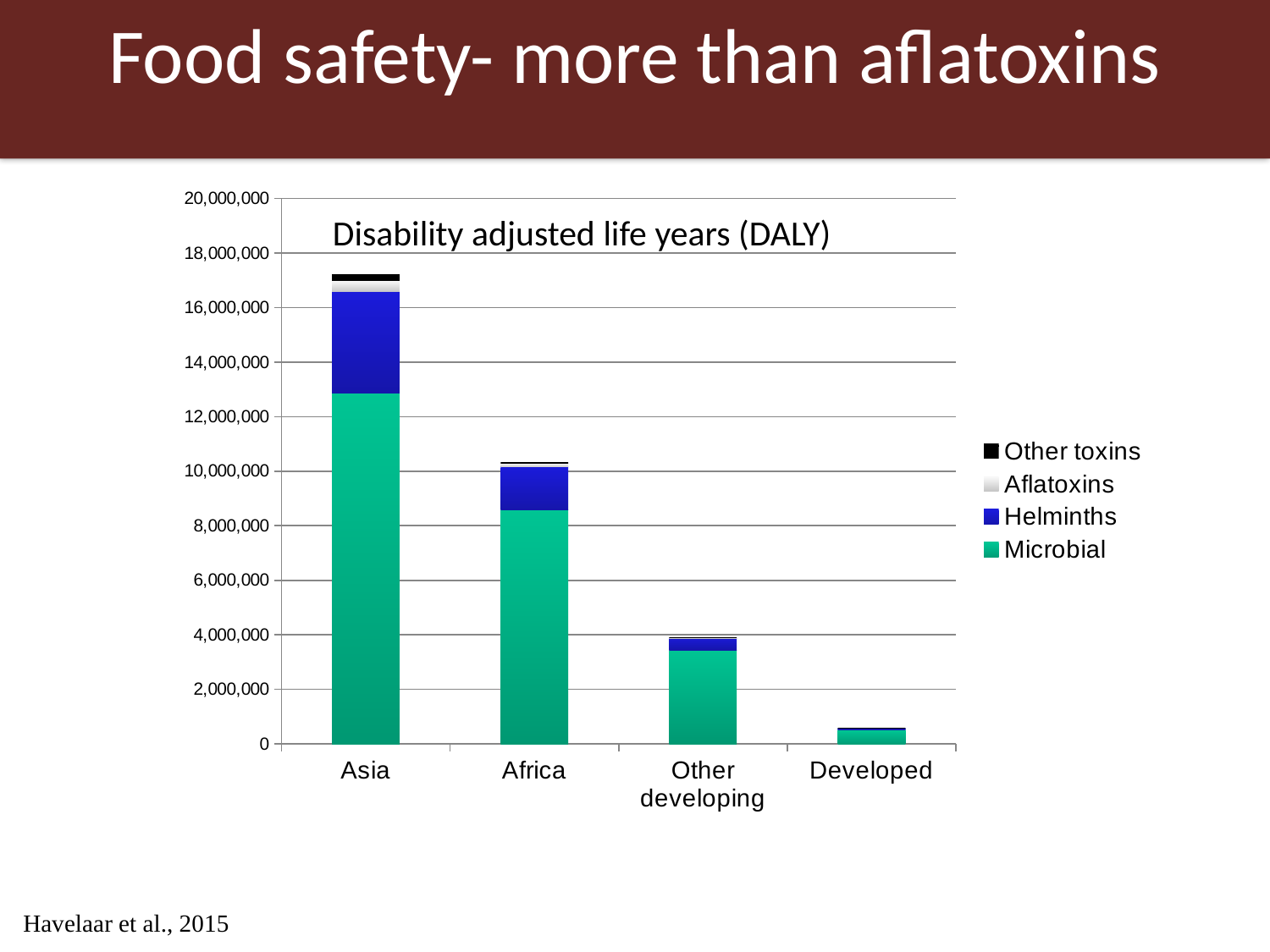
Do the total bar values rise or fall moving from Asia to Developed along the x axis? fall How many series does the chart legend list? 4 Which region has the lowest total stacked bar? Developed Is the total value for Developed greater or less than 2,000,000? less What is the title of the chart? Disability adjusted life years (DALY) How many categories are shown on the x axis of the chart? 4 Is the Microbial value for Asia greater or less than 12,000,000? greater What kind of chart is shown on the slide? Stacked bar chart Is the total value for Asia greater or less than 16,000,000? greater Which region has the highest total stacked bar? Asia Which series is shown in green in the chart? Microbial Which has a larger total bar, Africa or Other developing? Africa